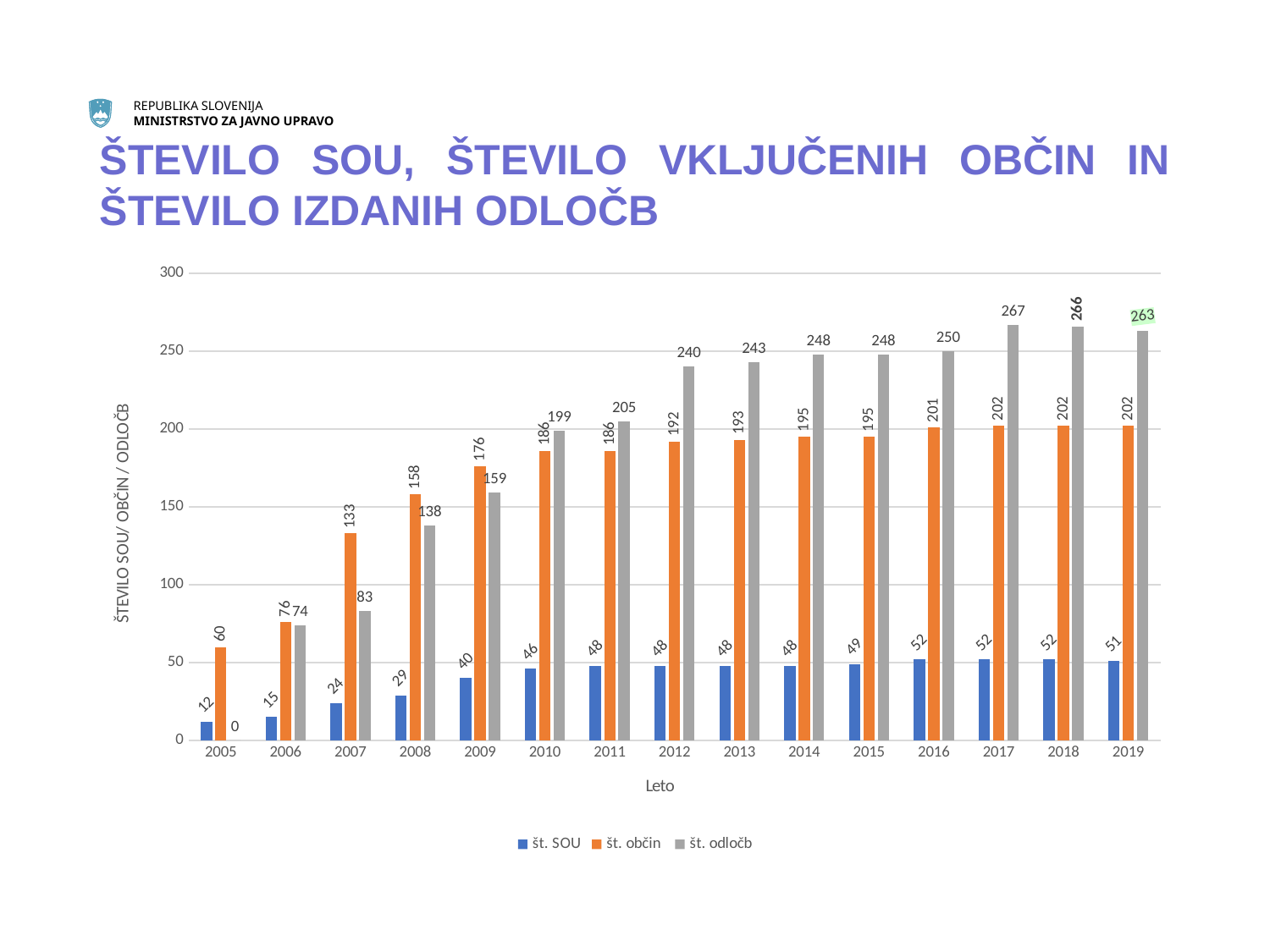
What is the value of št. odločb for 2017? 267 What is the value of št. občin for 2009? 176 How many series does the legend list? 3 How many years are shown on the x axis? 15 What is the value of št. odločb for 2005? 0 In which year is št. SOU lowest? 2005 What is the difference between št. odločb in 2019 and št. občin in 2019? 61 In which year is št. odločb highest? 2017 What kind of chart is shown on the slide? bar chart Which is larger in 2006: št. občin or št. odločb? št. občin Does št. občin generally rise or fall from 2005 to 2019? rise What is the value of št. SOU for 2019? 51